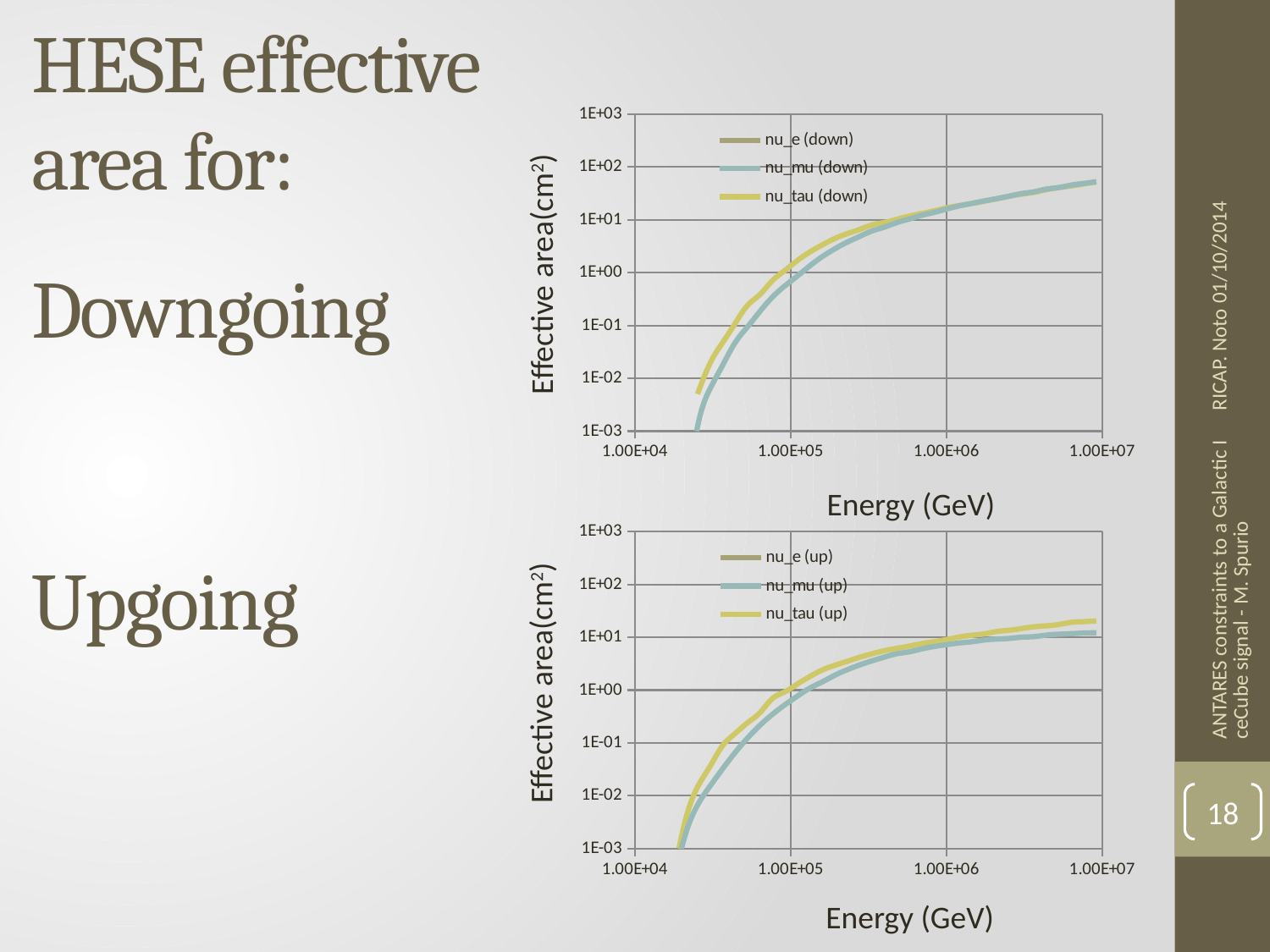
What kind of chart is the top chart (downgoing) on the slide? line chart In the bottom chart (upgoing), does the nu_mu (up) effective area rise or fall as energy increases? rise In the top chart (downgoing), is the nu_tau (down) effective area at 1.00E+07 GeV greater or less than 1E+01? greater In the bottom chart (upgoing), is the nu_mu (up) effective area at 1.00E+06 GeV greater or less than 1E+02? less In the top chart (downgoing), at 1.00E+05 GeV, which series has the larger effective area, nu_tau (down) or nu_mu (down)? nu_tau (down) How many series does the legend of the bottom chart (upgoing) list? 3 In the top chart (downgoing), is the nu_mu (down) effective area at 1.00E+05 GeV greater or less than 1E+01? less In the top chart (downgoing), does the nu_tau (down) effective area rise or fall as energy increases? rise In the bottom chart (upgoing), at 1.00E+07 GeV, which series has the larger effective area, nu_tau (up) or nu_mu (up)? nu_tau (up) What is the x-axis title of the bottom chart (upgoing)? Energy (GeV) How many series does the legend of the top chart (downgoing) list? 3 What kind of chart is the bottom chart (upgoing) on the slide? line chart